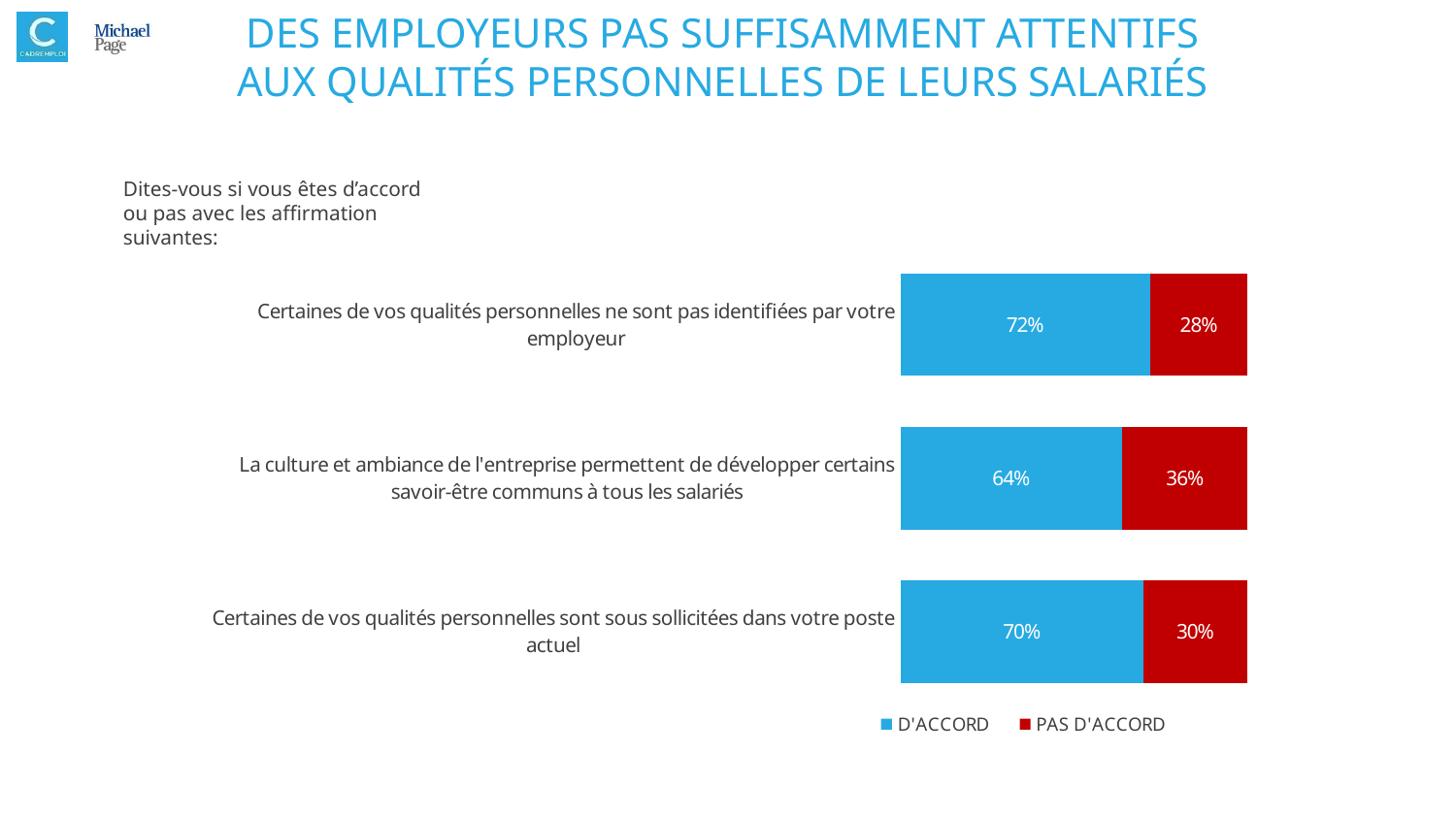
What is the total of the D'ACCORD and PAS D'ACCORD values for the statement about company culture? 100% Which is larger: the PAS D'ACCORD value for the statement about company culture, or the PAS D'ACCORD value for the statement about qualities under-solicited in the current position? The statement about company culture (36%) Which statement has the lowest D'ACCORD share? La culture et ambiance de l'entreprise permettent de développer certains savoir-être communs à tous les salariés What is the PAS D'ACCORD value for the statement 'La culture et ambiance de l'entreprise permettent de développer certains savoir-être communs à tous les salariés'? 36% Which colour represents PAS D'ACCORD in the chart? Red What type of chart is shown on the slide? Stacked bar chart How many statements are shown in the chart? 3 How many series does the legend list? 2 What is the difference between the D'ACCORD and PAS D'ACCORD values for the statement about personal qualities not identified by the employer? 44% What is the D'ACCORD value for the statement 'Certaines de vos qualités personnelles sont sous sollicitées dans votre poste actuel'? 70% What percentage of respondents agree (D'ACCORD) that some of their personal qualities are not identified by their employer? 72% Which statement has the highest D'ACCORD share? Certaines de vos qualités personnelles ne sont pas identifiées par votre employeur